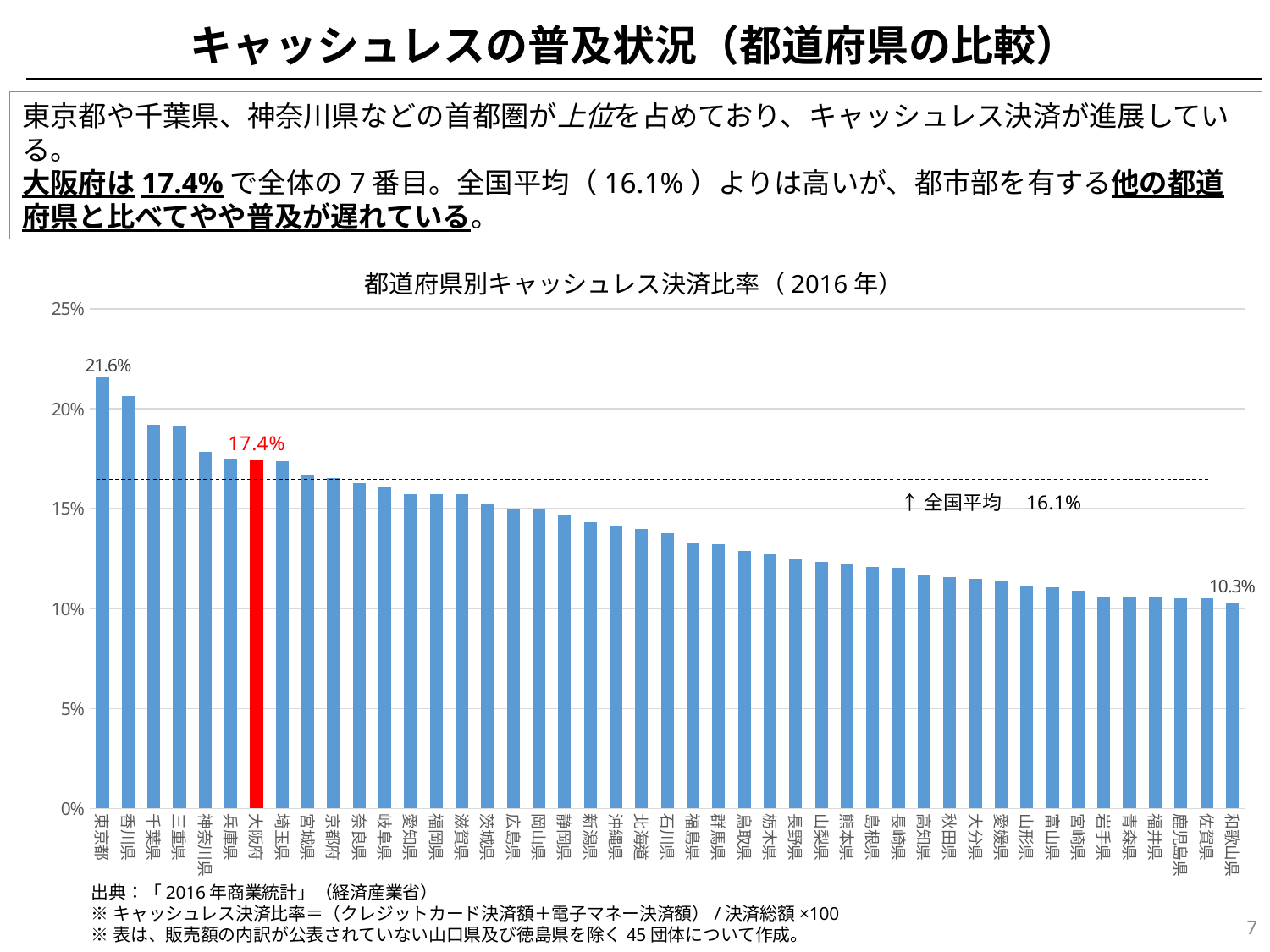
Which prefecture has the highest cashless payment ratio? 東京都 Which prefecture has the lowest cashless payment ratio? 和歌山県 What is the cashless payment ratio for 大阪府? 17.4% Is the value for 北海道 greater or less than 15%? less What value does the dashed horizontal line labelled 全国平均 represent? 16.1% What kind of chart is shown on the slide? bar chart What is the cashless payment ratio for 和歌山県? 10.3% What is the cashless payment ratio for 東京都? 21.6% How many prefectures are shown in the chart? 45 Is the value for 香川県 greater or less than 20%? greater What is the difference between the ratios for 大阪府 and 和歌山県? 7.1% How much higher is the ratio for 東京都 than for 大阪府? 4.2%